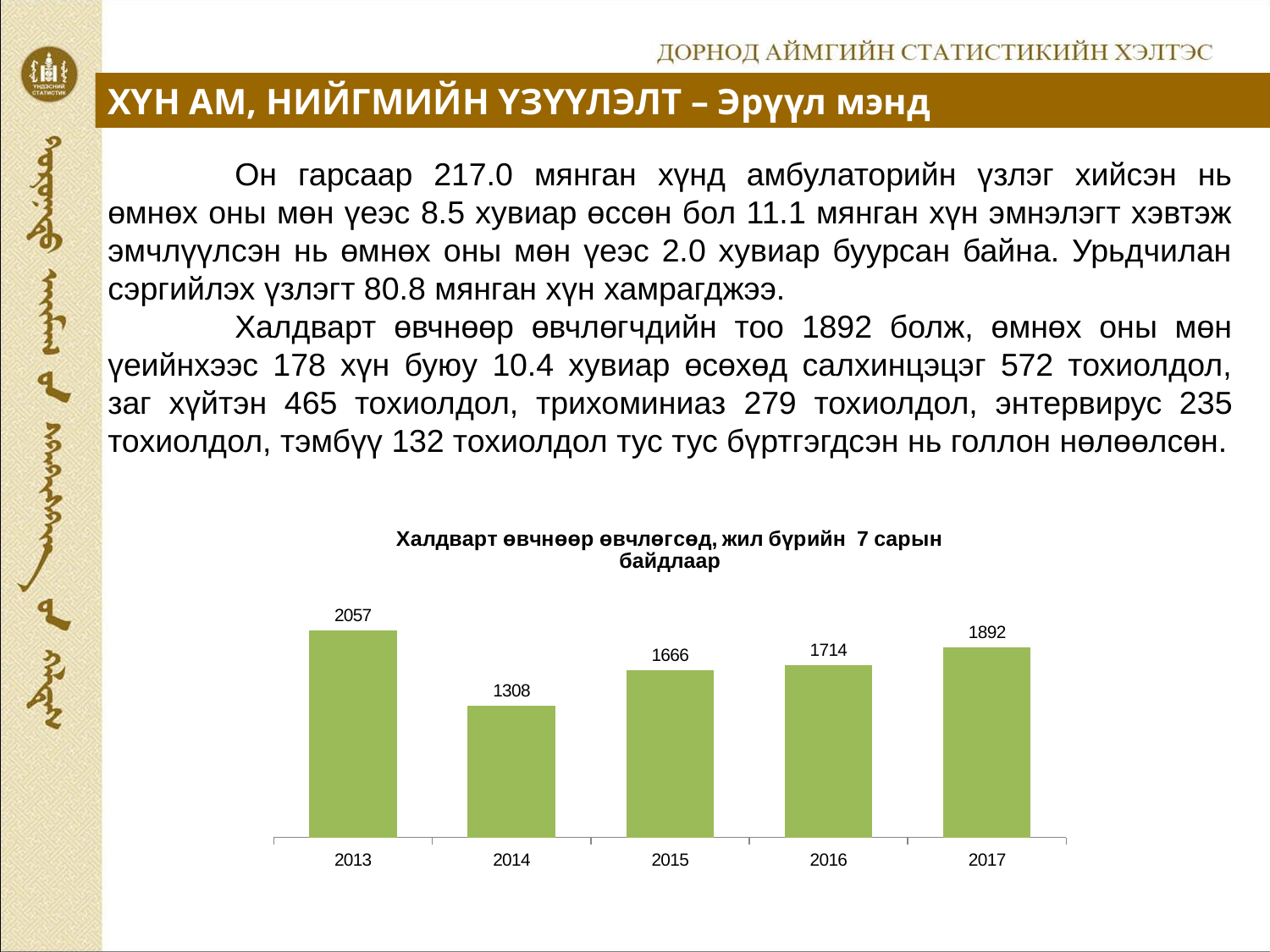
What is the value for 2013 in the chart? 2057 What is the value for 2014 in the chart? 1308 Which year has the lowest value in the chart? 2014 What kind of chart is shown on the slide? bar chart What is the value for 2017 in the chart? 1892 Which is larger, the value for 2015 or the value for 2016? 2016 What is the difference between the values for 2017 and 2016? 178 What is the title of the chart? Халдварт өвчнөөр өвчлөгсөд, жил бүрийн 7 сарын байдлаар Which year has the highest value in the chart? 2013 How many years are shown in the chart? 5 Do the values rise or fall from 2014 to 2017? rise What is the difference between the values for 2013 and 2014? 749